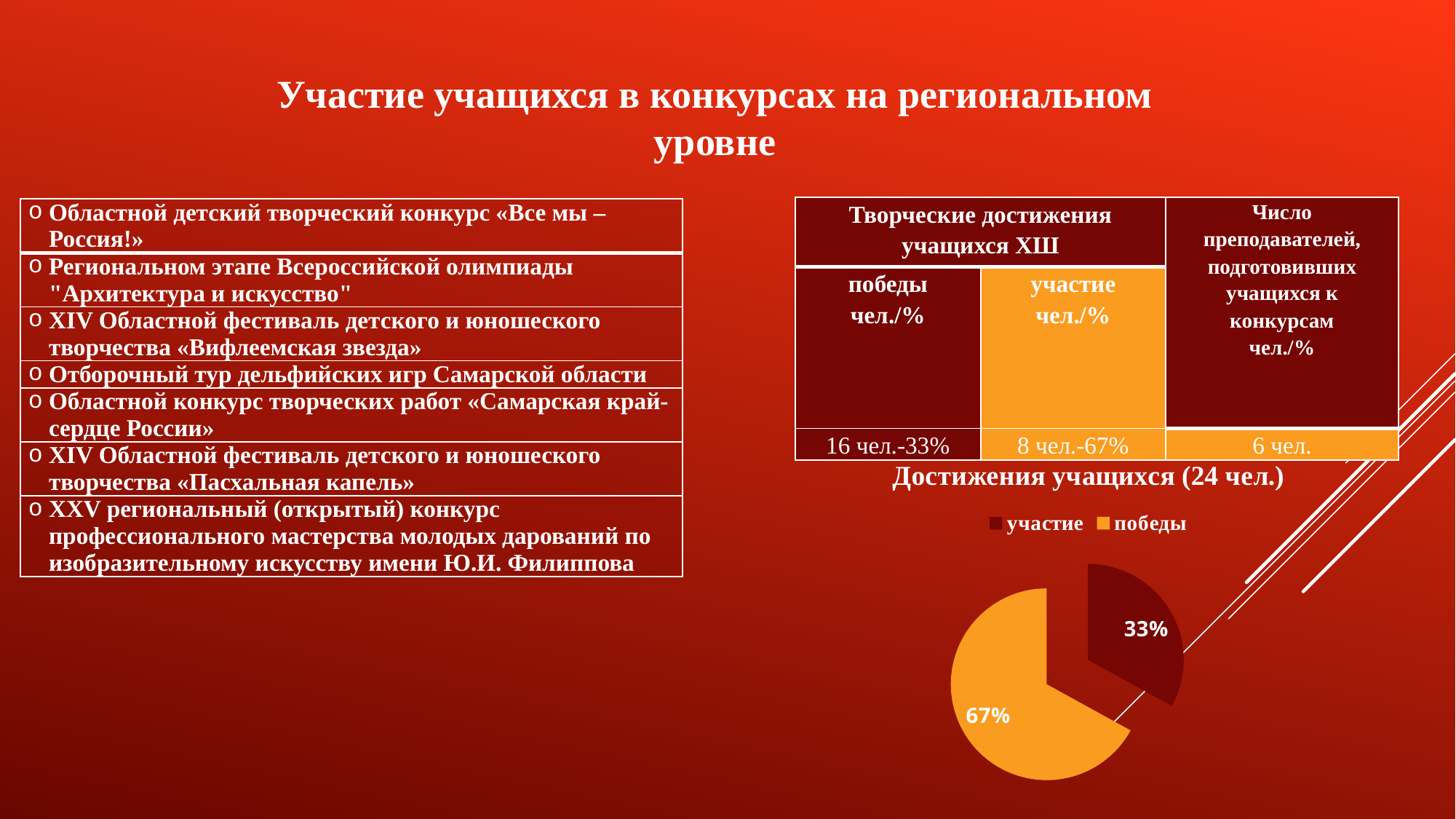
What kind of chart is shown on the slide? pie chart What share of the pie chart does the slice for «участие» take? 33% Which slice of the pie chart is the smallest? участие What is the title of the pie chart? Достижения учащихся (24 чел.) How many entries does the legend of the pie chart list? 2 In the pie chart, which is larger: the slice for «участие» or the slice for «победы»? победы Which slice of the pie chart is the largest? победы What is the difference in percentage points between the «победы» slice and the «участие» slice in the pie chart? 34% How many slices does the pie chart have? 2 What colour is the «победы» slice in the pie chart? orange Is the share of the «участие» slice in the pie chart greater or less than 50%? less What share of the pie chart does the slice for «победы» take? 67%